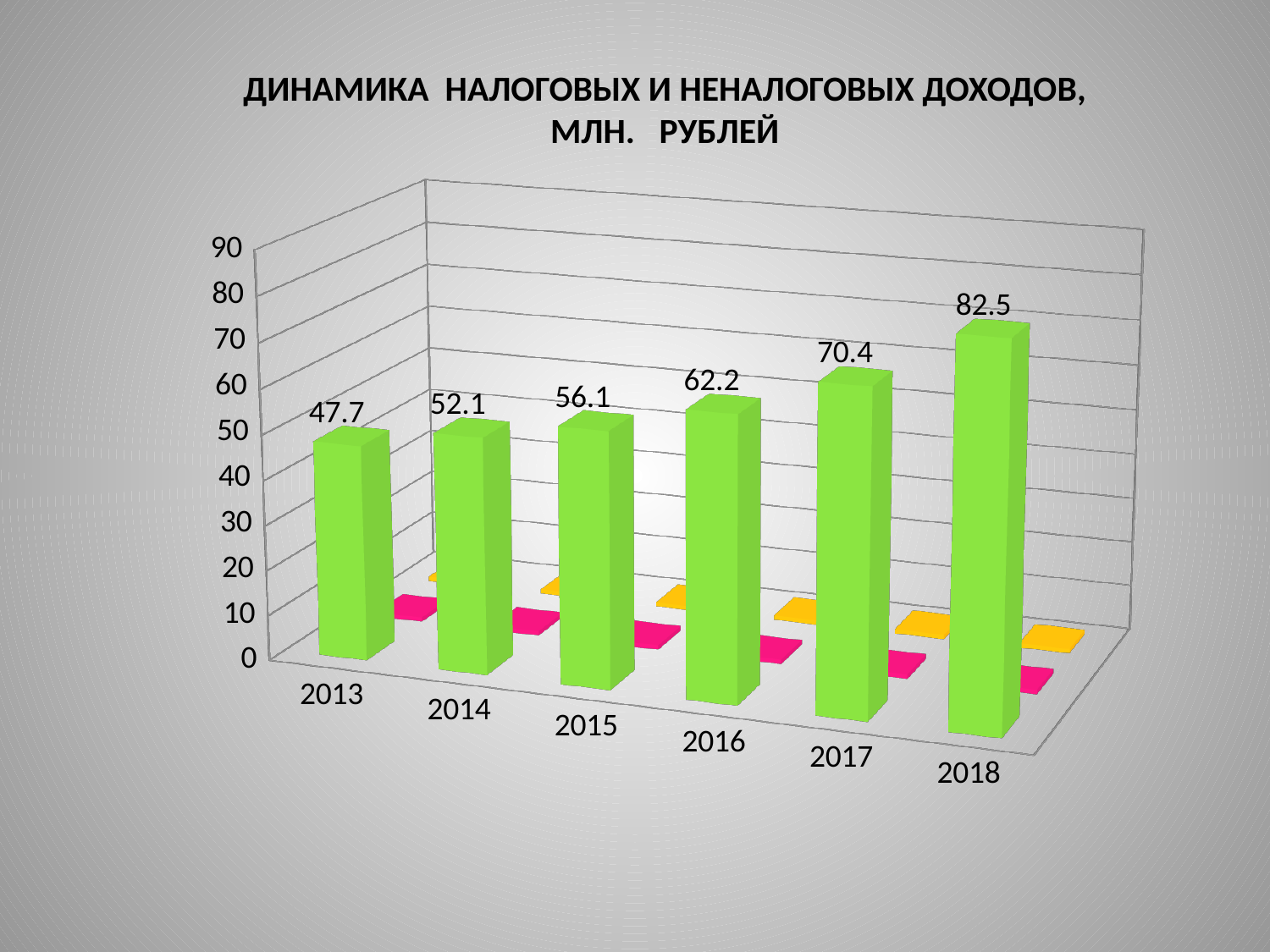
What is the difference between the green bar values for 2018 and 2017? 12.1 What is the value of the green bar for 2015? 56.1 Which is larger, the green bar for 2016 or the green bar for 2017? 2017 How many years are shown on the x axis? 6 Which year has the highest green bar? 2018 What is the difference between the green bar values for 2014 and 2013? 4.4 What is the value of the green bar for 2013? 47.7 What is the value of the green bar for 2018? 82.5 What kind of chart is shown on the slide? bar chart What is the value of the green bar for 2016? 62.2 Which year has the lowest green bar? 2013 Do the green bar values rise or fall from 2013 to 2018? rise